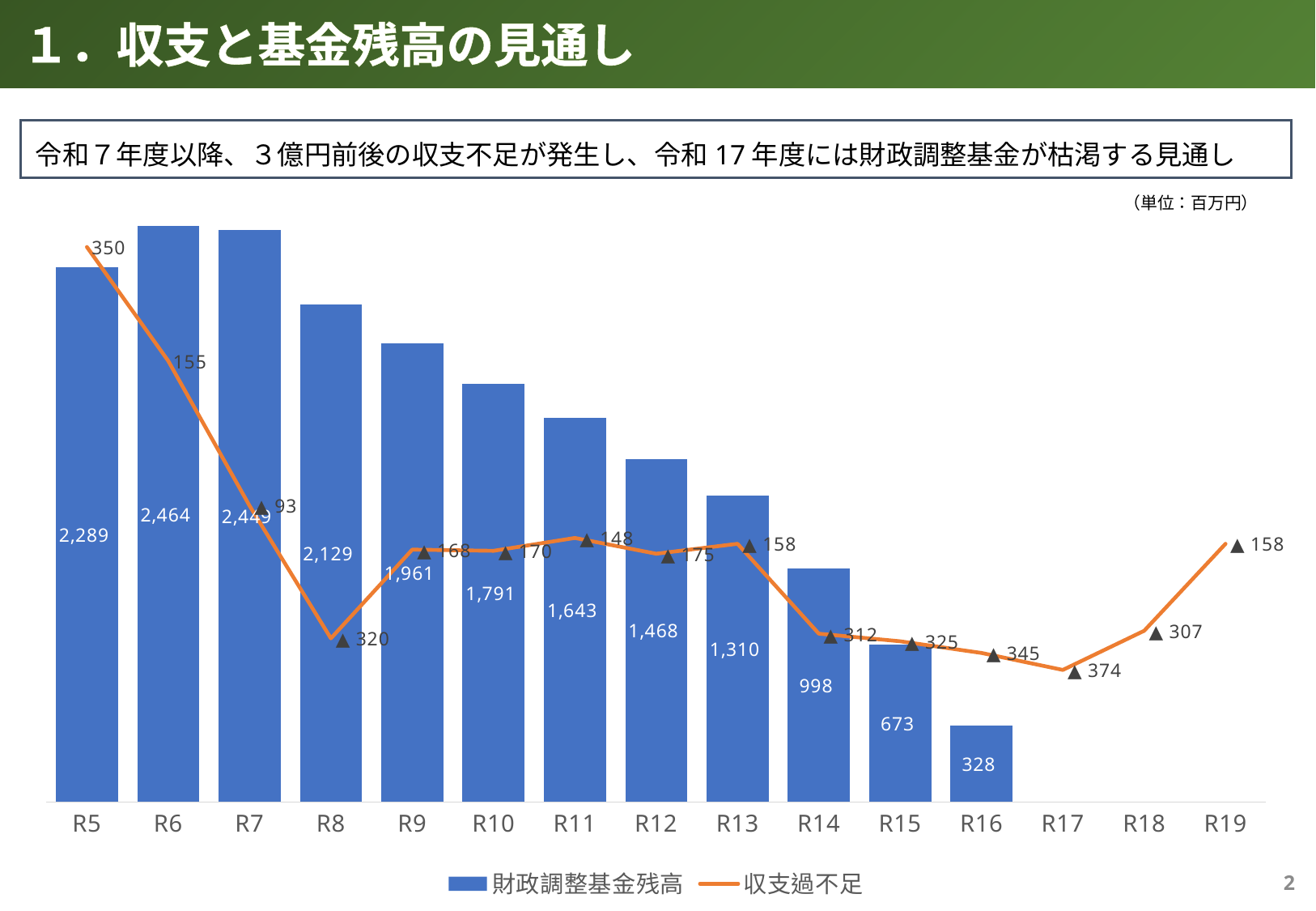
What is the 収支過不足 value for R5? 350 What is the 財政調整基金残高 value for R14? 998 Does the 財政調整基金残高 rise or fall from R6 to R16? Fall What is the 収支過不足 value for R17? ▲374 What is the 財政調整基金残高 value for R5? 2,289 What kind of chart is this? Combined bar and line chart How many series does the legend list? 2 What is the difference between the 財政調整基金残高 values for R5 and R16? 1,961 Which is larger, the 財政調整基金残高 for R6 or for R7? R6 In which year is the 財政調整基金残高 bar highest? R6 Among the years with a 財政調整基金残高 bar, which year has the lowest value? R16 How many years are shown on the x axis? 15